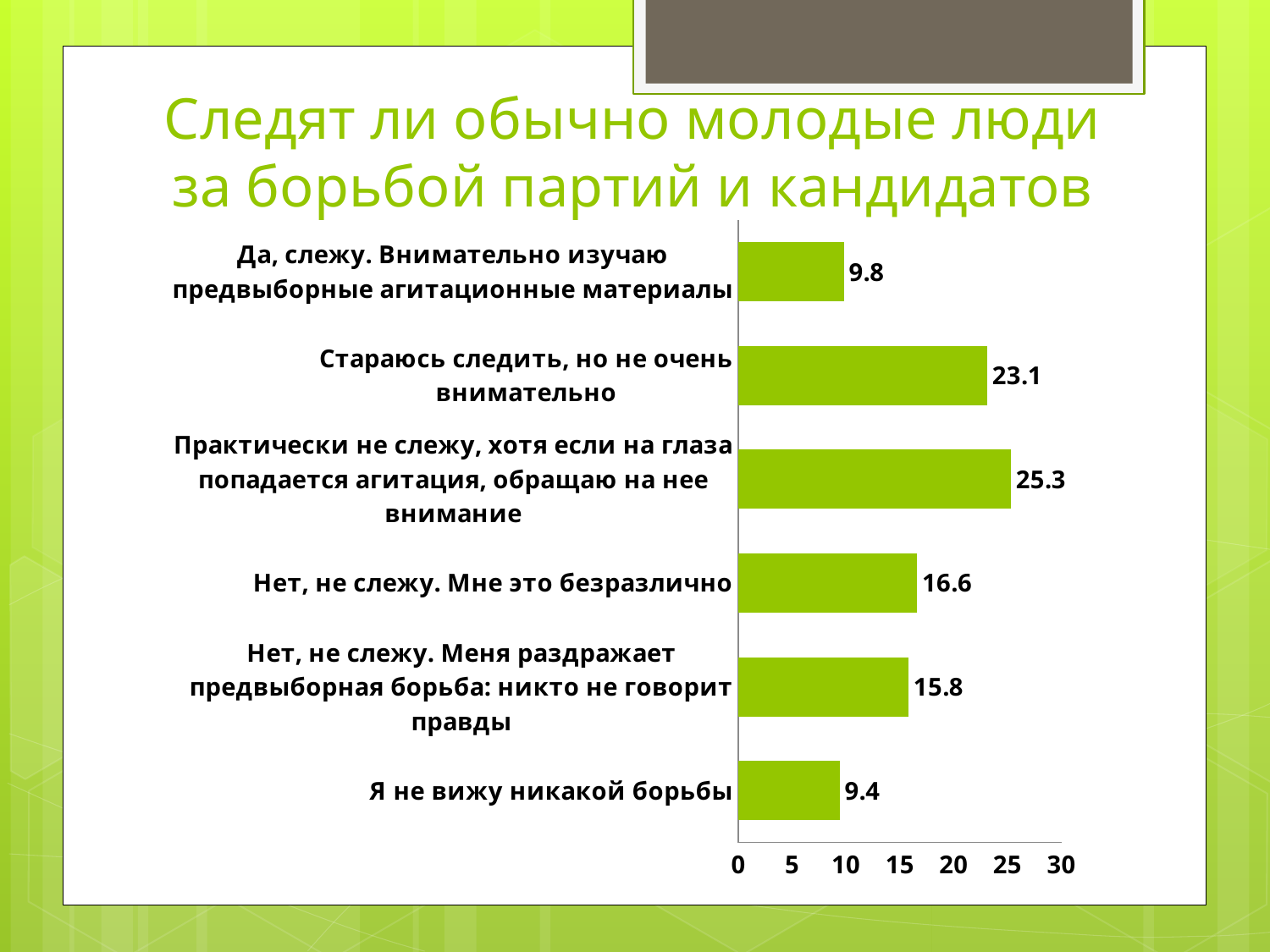
What is the difference between the values for "Да, слежу. Внимательно изучаю предвыборные агитационные материалы" and "Я не вижу никакой борьбы"? 0.4 Is the value for "Да, слежу. Внимательно изучаю предвыборные агитационные материалы" greater or less than 10? less What is the title of the slide? Следят ли обычно молодые люди за борьбой партий и кандидатов Which is larger: the value for "Нет, не слежу. Мне это безразлично" or the value for "Нет, не слежу. Меня раздражает предвыборная борьба: никто не говорит правды"? Нет, не слежу. Мне это безразлично Which category has the lowest value? Я не вижу никакой борьбы What kind of chart is shown on the slide? bar chart What value is shown for "Стараюсь следить, но не очень внимательно"? 23.1 How many categories are shown in the chart? 6 What value is shown for "Нет, не слежу. Мне это безразлично"? 16.6 Which category has the highest value? Практически не слежу, хотя если на глаза попадается агитация, обращаю на нее внимание What is the difference between the values for "Практически не слежу, хотя если на глаза попадается агитация, обращаю на нее внимание" and "Стараюсь следить, но не очень внимательно"? 2.2 What value is shown for "Я не вижу никакой борьбы"? 9.4